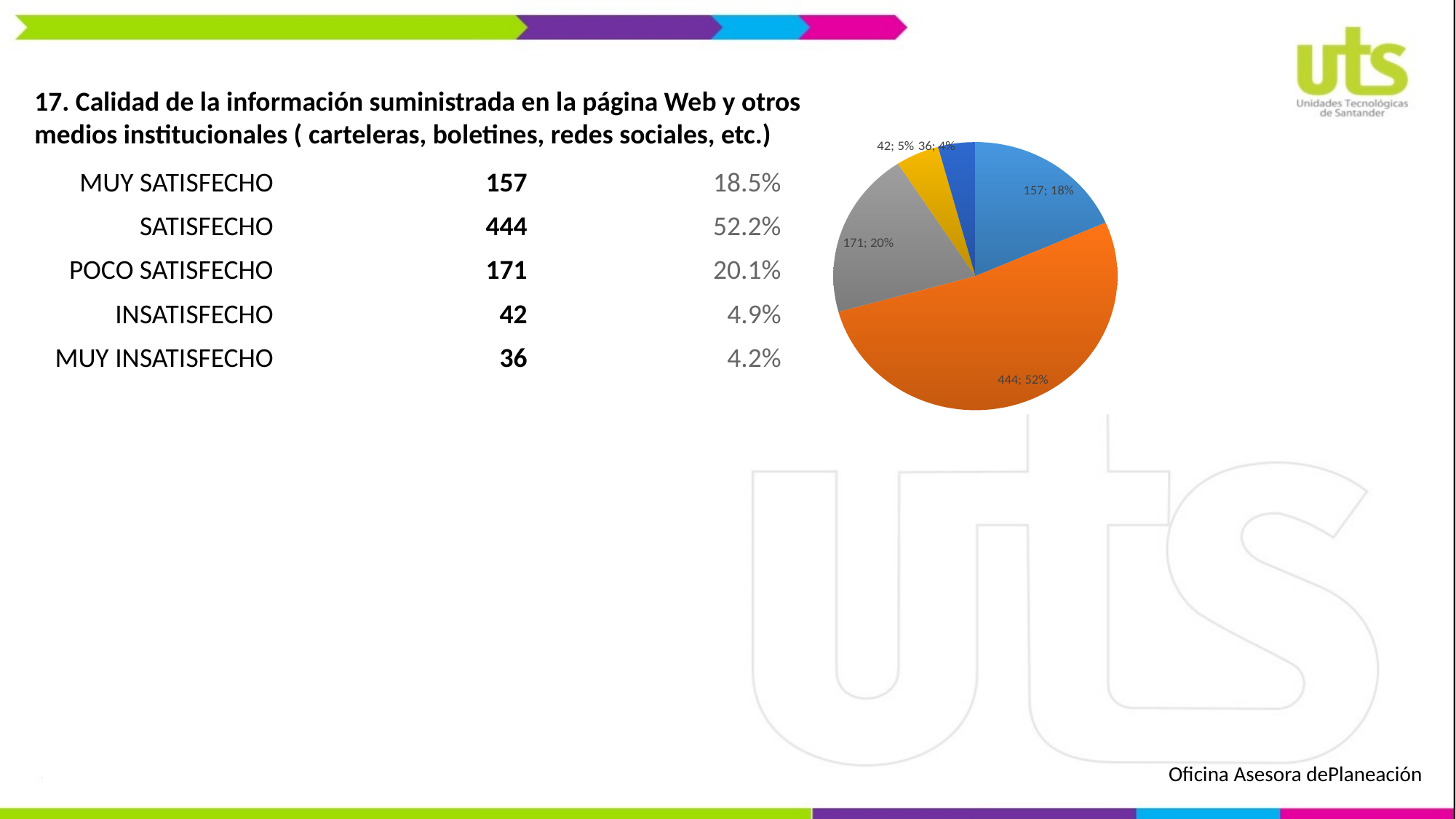
According to the pie chart labels, what is the difference between the values of the largest slice (444) and the slice labelled 171? 273 What colour is the largest slice of the pie chart? orange What percentage share does the pie chart label give for the slice with value 171? 20% What is the total of all the values shown on the pie chart slices? 850 Which slice is larger in the pie chart: the one labelled 157 or the one labelled 171? 171 What kind of chart is shown on the slide? pie chart What value is shown on the smallest slice of the pie chart? 36 How many slices does the pie chart have? 5 What value is shown on the largest slice of the pie chart? 444 What percentage share does the pie chart label give for the slice with value 42? 5% What percentage share does the pie chart label give for the slice with value 157? 18%